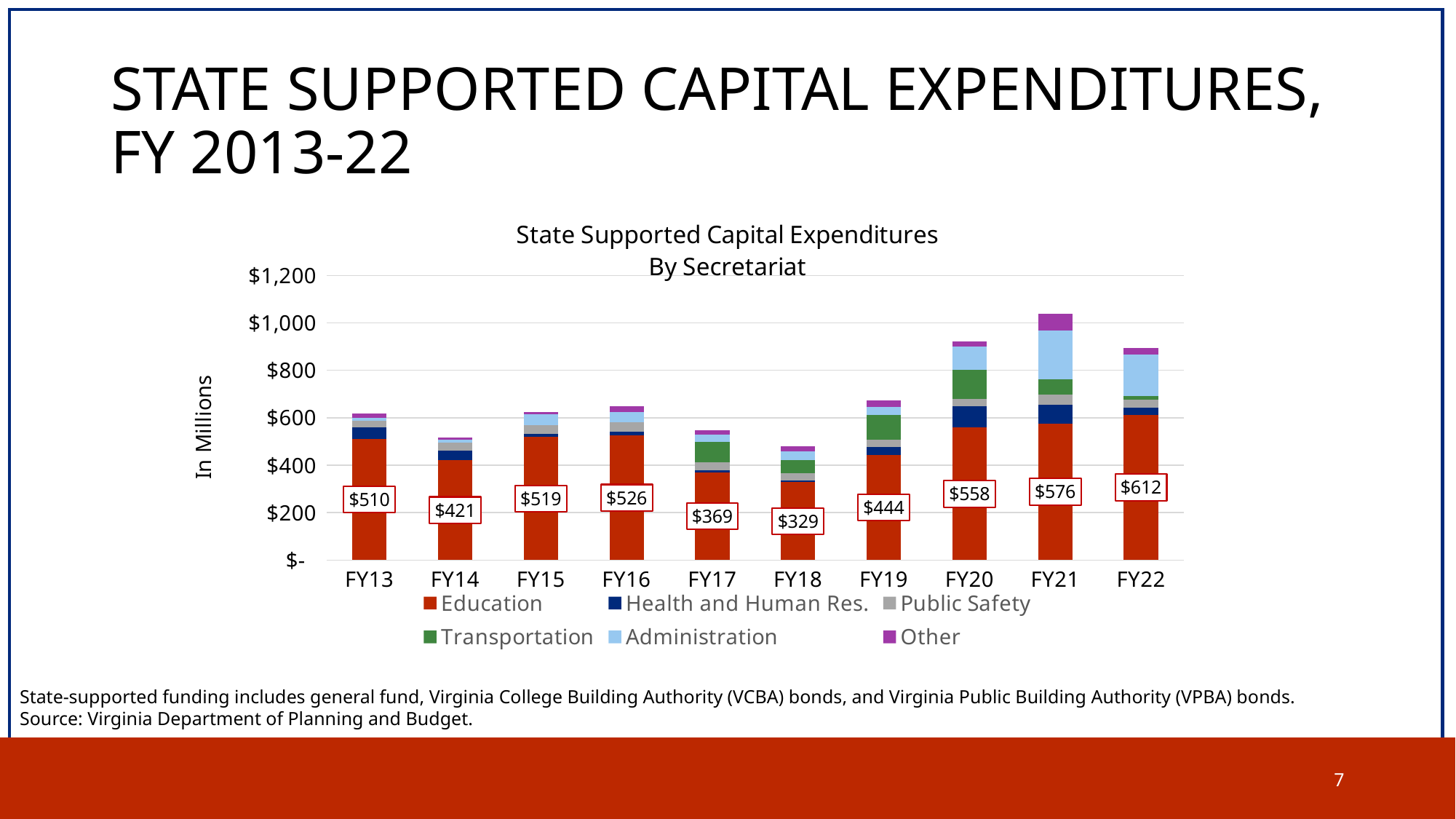
How many fiscal years are shown on the x axis? 10 Which fiscal year has the highest labeled Education value? FY22 Which fiscal year has the lowest labeled Education value? FY18 Which is larger, the Education value for FY15 or for FY16? FY16 What is the Education value for FY20? $558 What is the Education value for FY14? $421 What kind of chart is shown on the slide? Stacked bar chart Do the labeled Education values rise or fall from FY18 to FY22? Rise What is the difference between the Education values for FY22 and FY21? $36 How many series does the legend list? 6 Is the total height of the FY18 stacked bar greater or less than $600? less Is the total height of the FY21 stacked bar greater or less than $1,000? greater